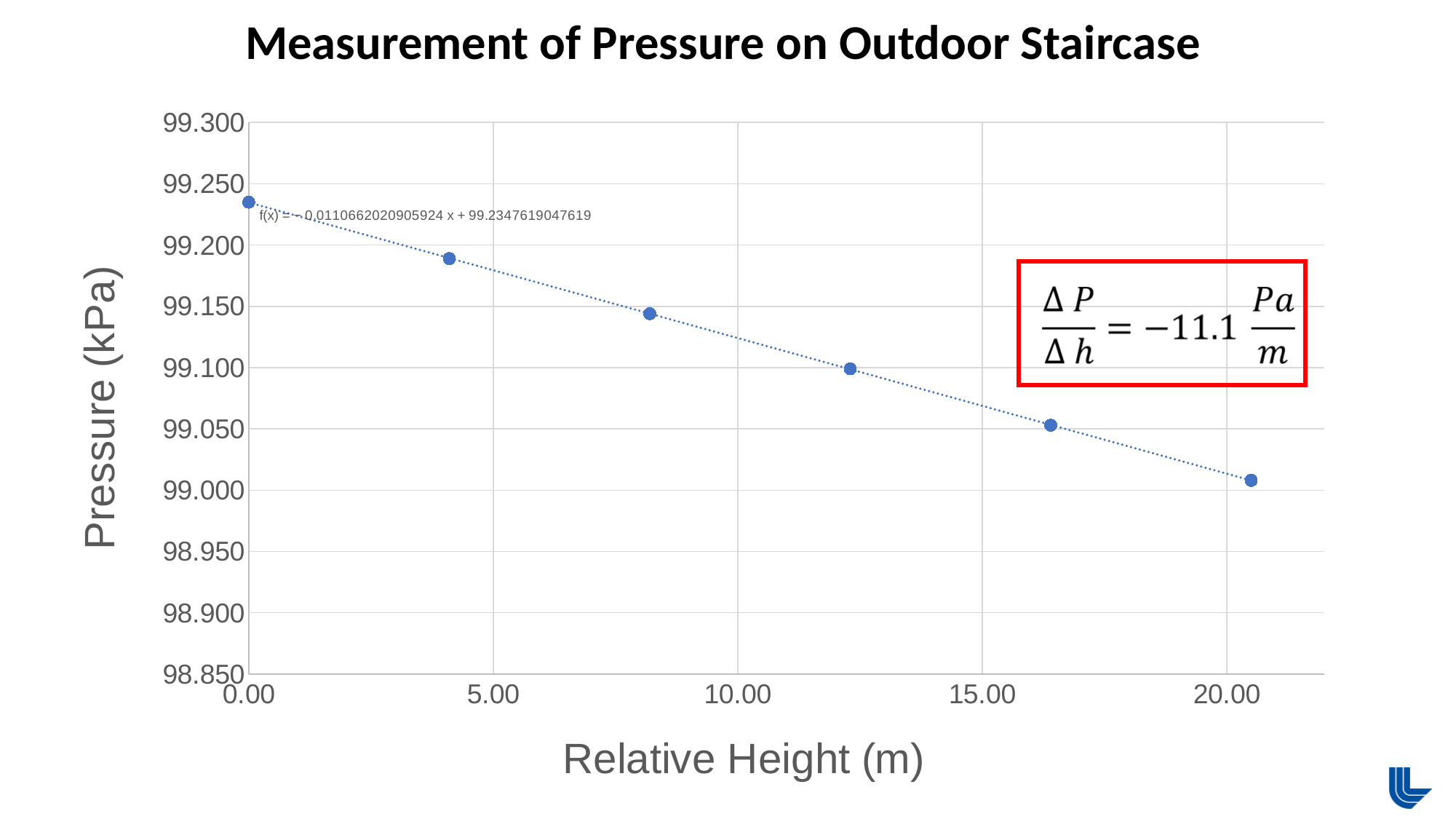
Which is larger: the pressure at about 4 m relative height or the pressure at about 12 m relative height? The pressure at about 4 m Which plotted point has the highest pressure: the one at the lowest relative height or the one at the highest relative height? The one at the lowest relative height Is the pressure value for the point at a relative height of 0.00 m greater or less than 99.200 kPa? greater Is the pressure value for the point at roughly 8 m relative height greater or less than 99.100 kPa? greater Do the pressure values rise or fall as relative height increases along the x axis? Fall How many data points are plotted on the chart? 6 What kind of chart is shown on the slide? Scatter plot Is the pressure value for the point at roughly 16 m relative height greater or less than 99.100 kPa? less What is the label of the y axis? Pressure (kPa) What is the title of the chart? Measurement of Pressure on Outdoor Staircase